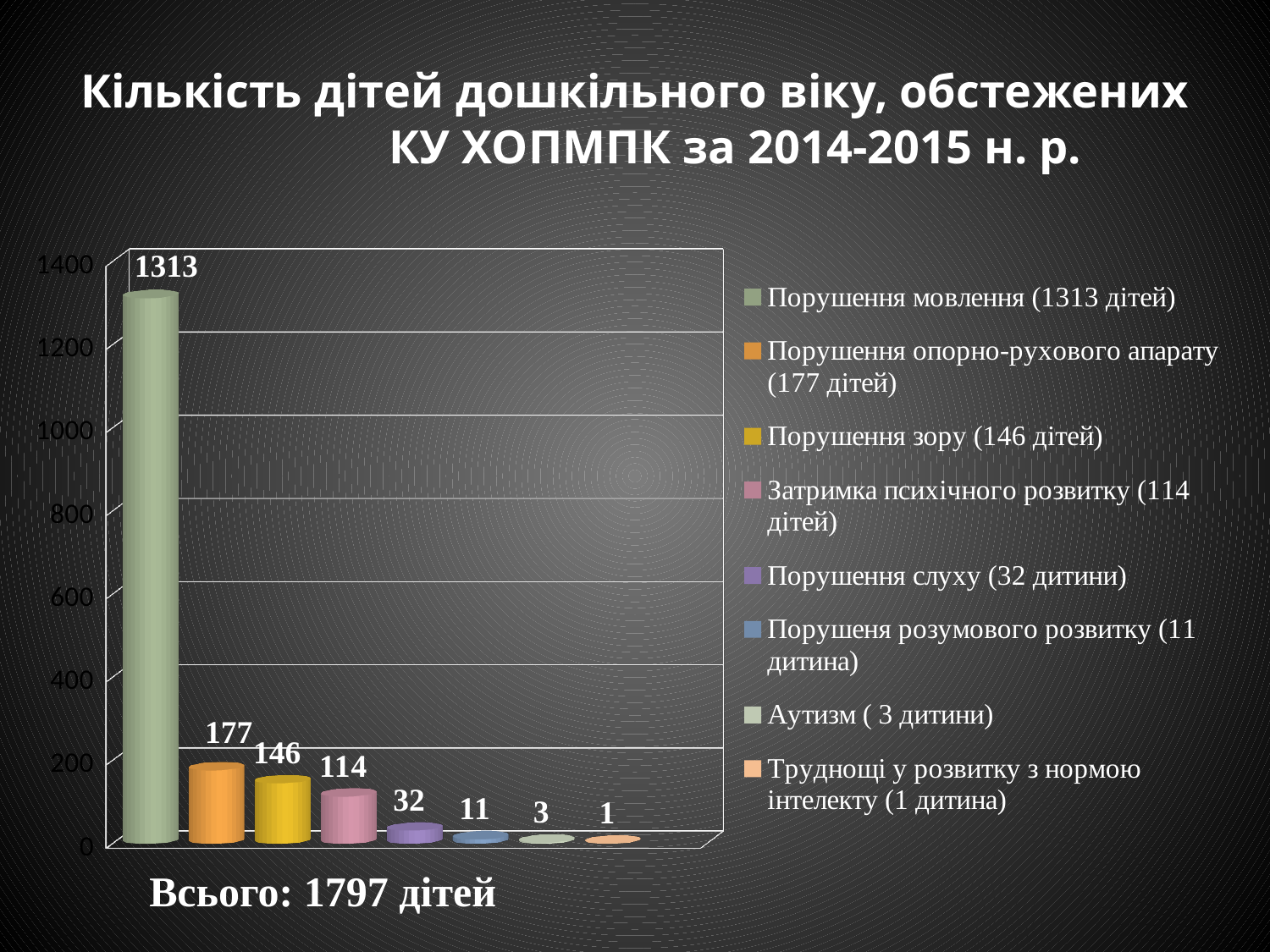
What is the value for Порушення мовлення? 1313 How many bars are plotted in the chart? 8 What type of chart is shown on the slide? bar chart Which category has the highest value? Порушення мовлення How many entries does the chart legend list? 8 Which category has the lowest value? Труднощі у розвитку з нормою інтелекту What is the value for Затримка психічного розвитку? 114 What is the value for Порушення слуху? 32 What is the value for Порушення опорно-рухового апарату? 177 What is the difference between the values for Порушення опорно-рухового апарату and Порушення зору? 31 What total number of children is stated below the chart? 1797 дітей Which is larger, the value for Порушення зору or the value for Затримка психічного розвитку? Порушення зору